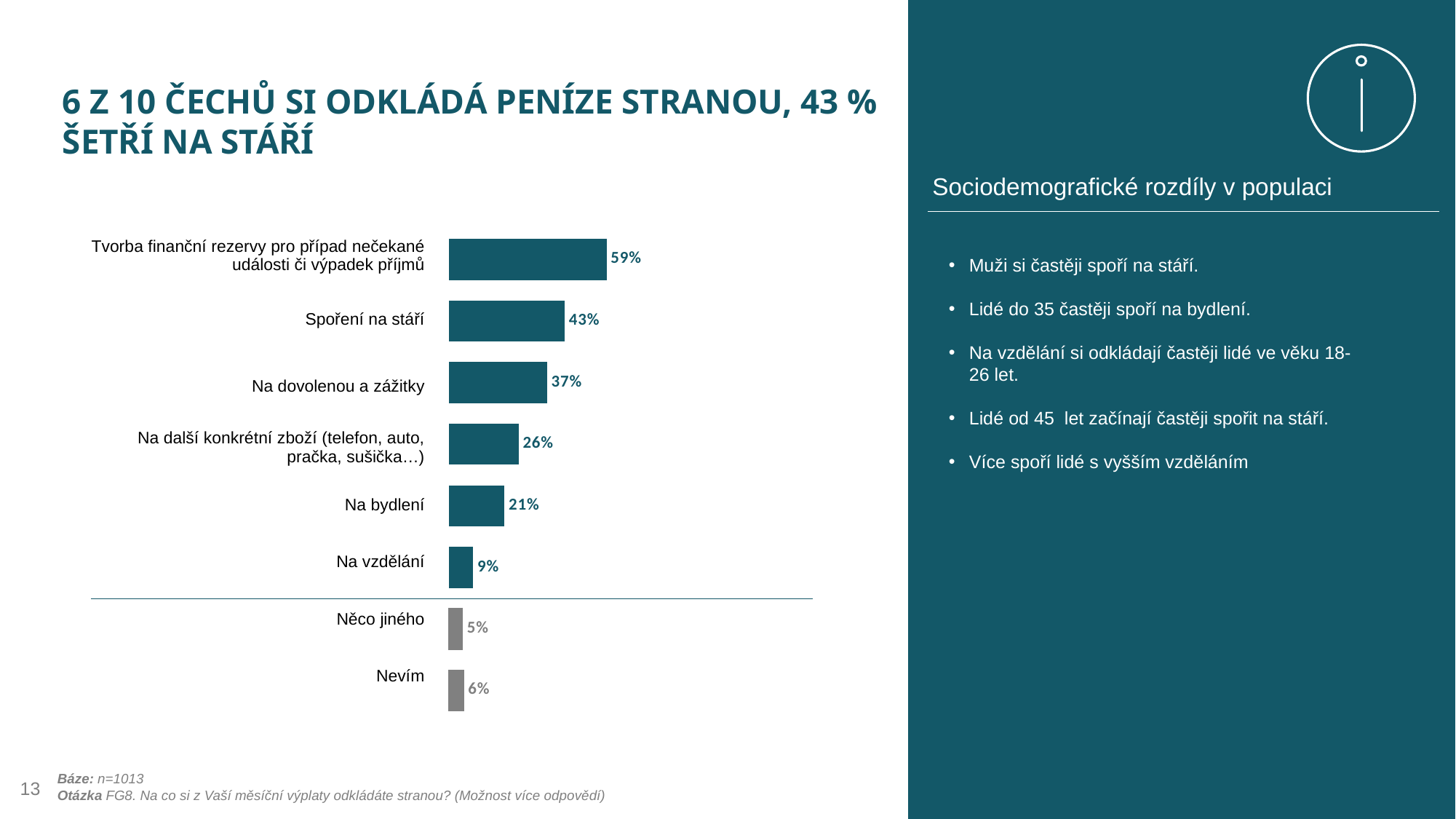
Which category has the lowest value? Něco jiného What is the value for "Na vzdělání"? 9% What is the value for "Na bydlení"? 21% What is the difference between the values for "Na dovolenou a zážitky" and "Na další konkrétní zboží (telefon, auto, pračka, sušička…)"? 11% Which is larger, the value for "Na bydlení" or the value for "Na vzdělání"? Na bydlení What is the difference between the values for "Tvorba finanční rezervy pro případ nečekané události či výpadek příjmů" and "Spoření na stáří"? 16% Which category has the highest value? Tvorba finanční rezervy pro případ nečekané události či výpadek příjmů What is the value for "Nevím"? 6% How many categories are shown in the chart? 8 What is the value for "Spoření na stáří"? 43% What kind of chart is shown on the slide? Bar chart Which two categories are shown with grey bars instead of teal? Něco jiného and Nevím